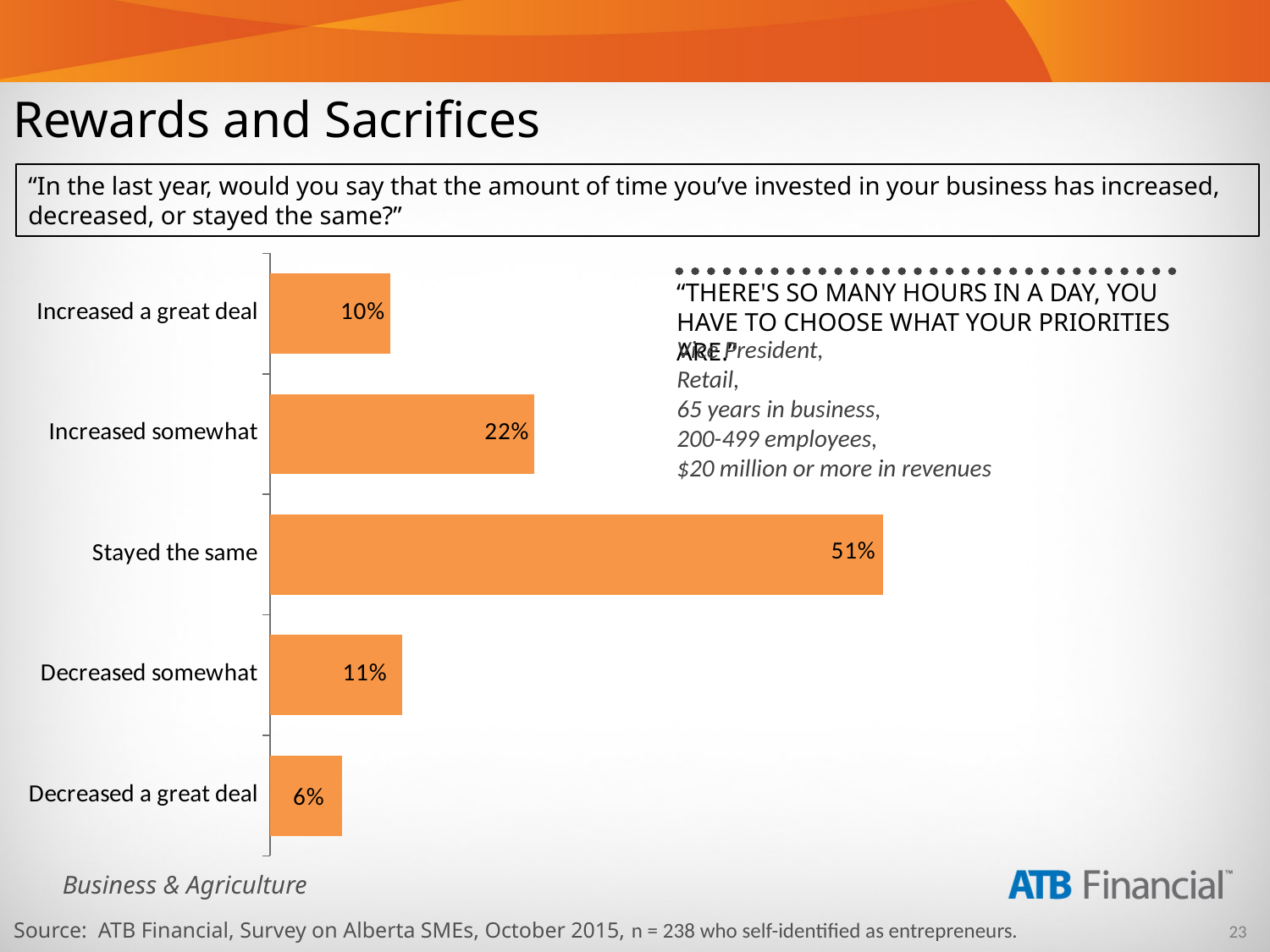
What is the value shown for 'Increased somewhat'? 22% What percentage of respondents said the time invested in their business 'Stayed the same'? 51% Which category has the lowest value? Decreased a great deal Which is larger, 'Increased somewhat' or 'Decreased somewhat'? Increased somewhat Which category has the highest value? Stayed the same What is the value shown for 'Decreased a great deal'? 6% What is the value shown for 'Increased a great deal'? 10% What is the difference between 'Stayed the same' and 'Increased somewhat'? 29% What kind of chart is shown on the slide? Bar chart What colour are the bars in the chart? Orange How many categories are shown in the chart? 5 What is the difference between 'Decreased somewhat' and 'Decreased a great deal'? 5%